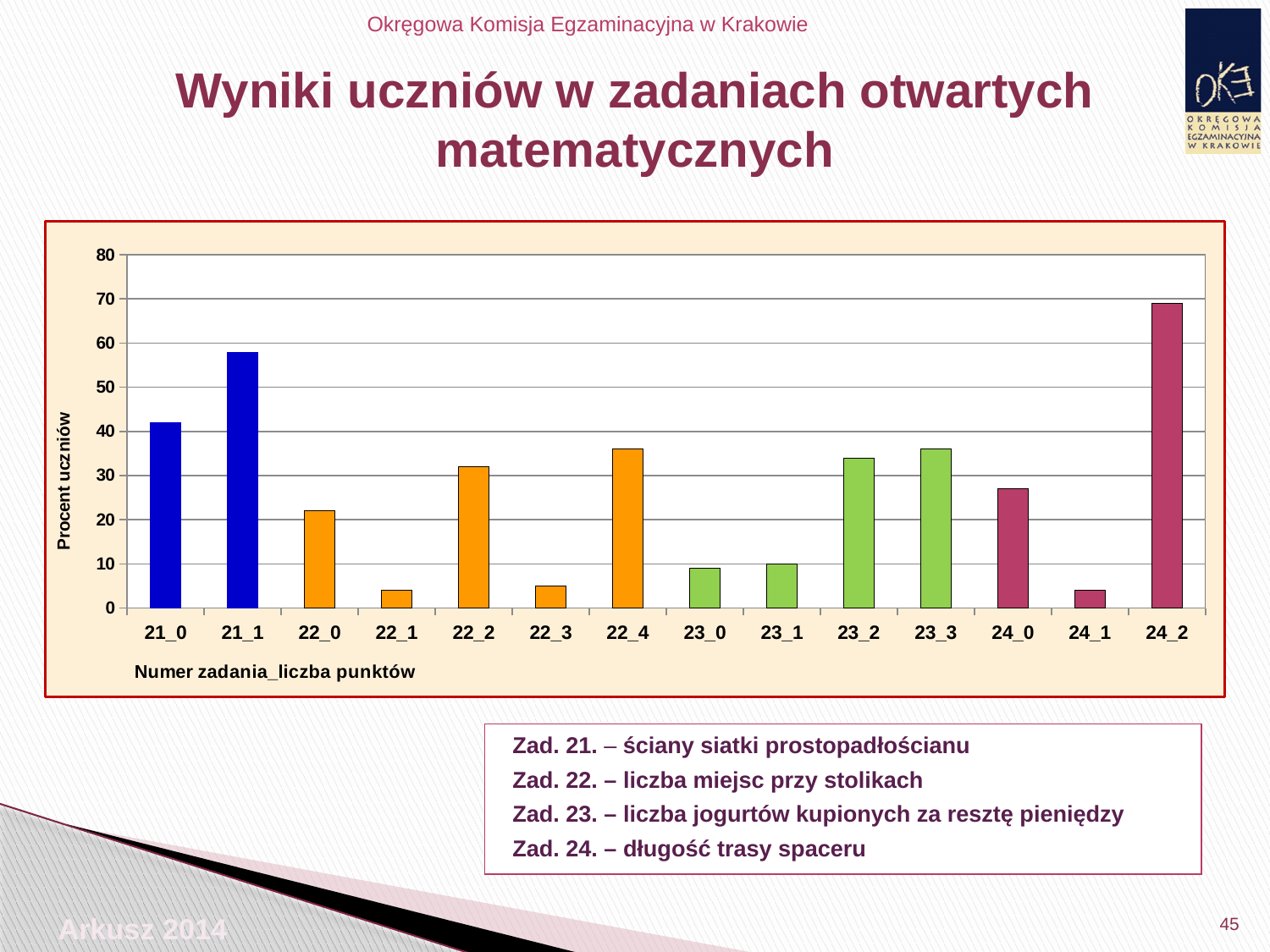
Is the value for 22_1 greater or less than 10? less What kind of chart is shown on the slide? bar chart Which is larger, the value for 22_4 or the value for 22_0? 22_4 Which category has the highest value in the chart? 24_2 Is the value for 24_2 greater or less than 60? greater How many categories are shown on the x axis of the chart? 14 Is the value for 21_1 greater or less than 50? greater Which is larger, the value for 21_1 or the value for 21_0? 21_1 What is the title of the vertical axis of the chart? Procent uczniów